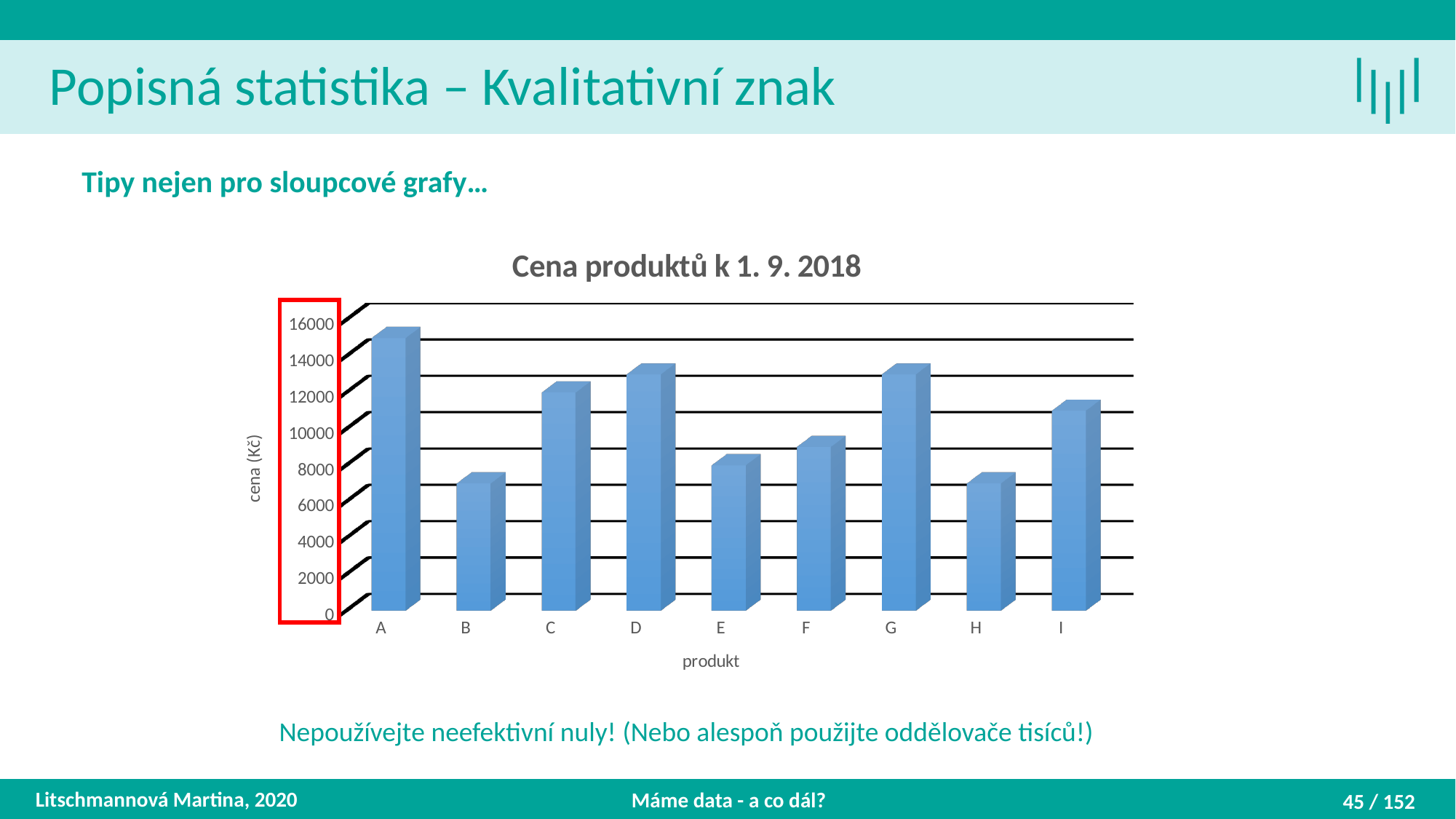
Which product has the highest price in the chart? A Is the value for product A greater or less than 14000? greater Is the value for product E greater or less than 10000? less How many products (categories) are shown on the x axis of the chart? 9 Which has the larger value, product A or product B? A Is the value for product C greater or less than 10000? greater Which has the larger value, product E or product C? C What kind of chart is shown on the slide? bar chart What is the label of the vertical axis of the chart? cena (Kč) What is the title of the chart? Cena produktů k 1. 9. 2018